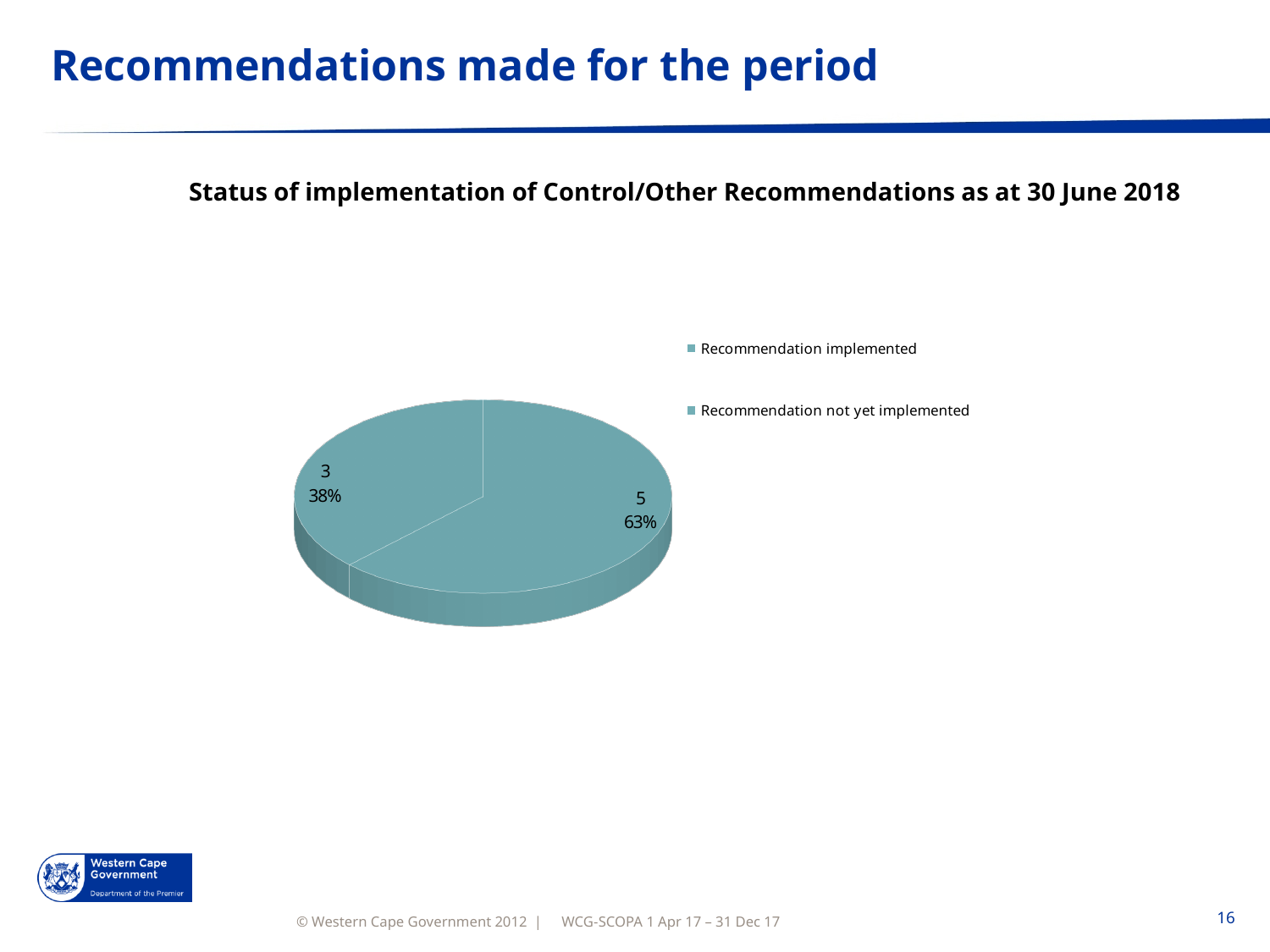
What is the difference between the counts shown on the two slices of the pie? 2 What kind of chart is shown on the slide? Pie chart What is the total number of recommendations represented by the two slices of the pie? 8 What is the title of the chart? Status of implementation of Control/Other Recommendations as at 30 June 2018 How many slices does the pie chart have? 2 What are the two entries listed in the chart legend? Recommendation implemented; Recommendation not yet implemented What is the count shown on the smallest slice of the pie? 3 What is the count shown on the largest slice of the pie? 5 What percentage share is shown on the smallest slice of the pie? 38% How many entries does the chart legend list? 2 What percentage share is shown on the largest slice of the pie? 63%